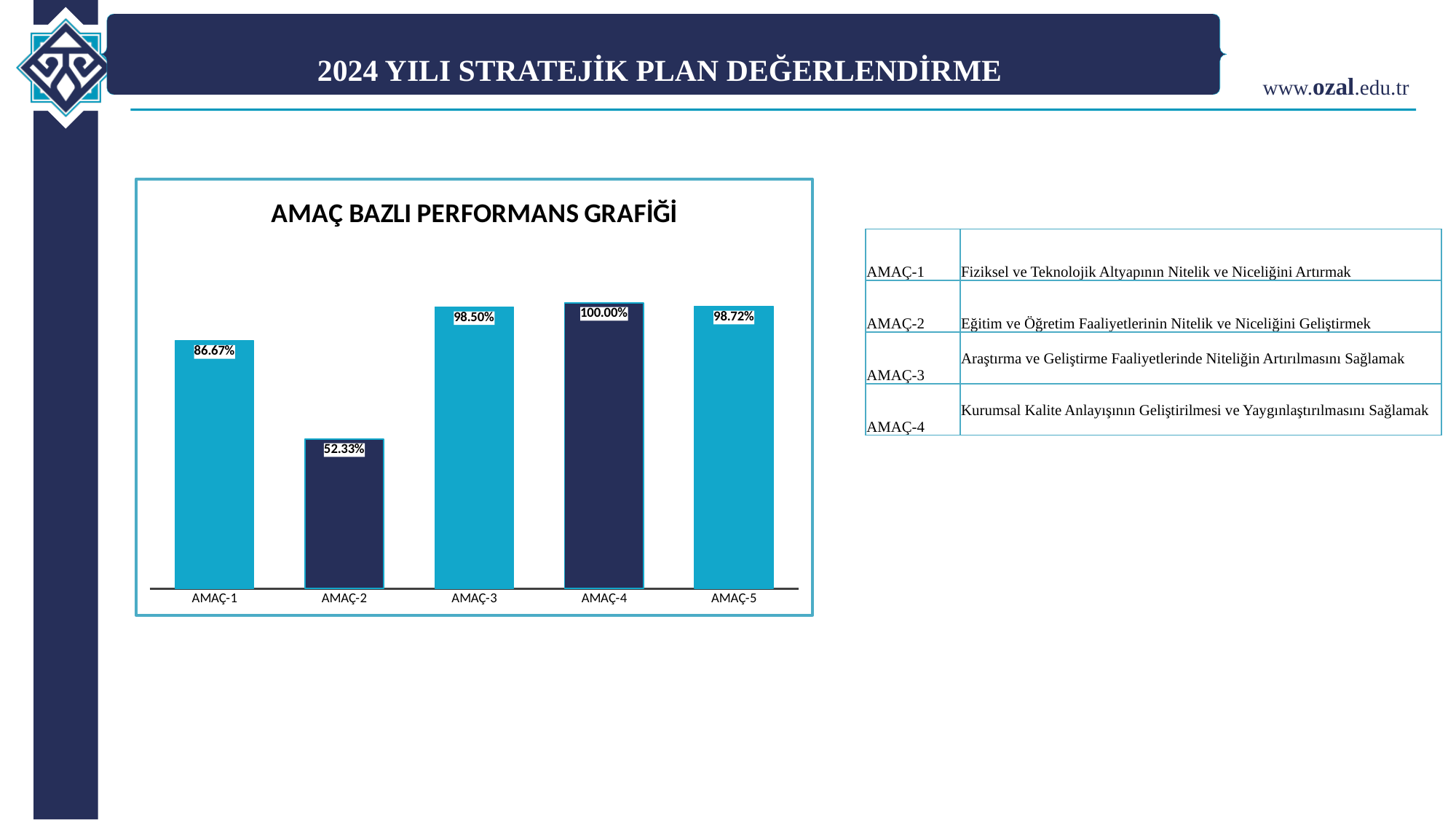
Which is larger, the value for AMAÇ-1 or the value for AMAÇ-2? AMAÇ-1 Which category has the lowest value in the chart? AMAÇ-2 How many categories are shown in the chart? 5 What type of chart is shown on the slide? Bar chart What is the value for AMAÇ-5 in the chart? 98.72% What is the value for AMAÇ-4 in the chart? 100.00% What is the value for AMAÇ-3 in the chart? 98.50% What is the difference between the values for AMAÇ-1 and AMAÇ-2? 34.34% What is the value for AMAÇ-2 in the chart? 52.33% What is the difference between the values for AMAÇ-4 and AMAÇ-2? 47.67% What is the value for AMAÇ-1 in the AMAÇ BAZLI PERFORMANS GRAFİĞİ chart? 86.67% Which category has the highest value in the chart? AMAÇ-4